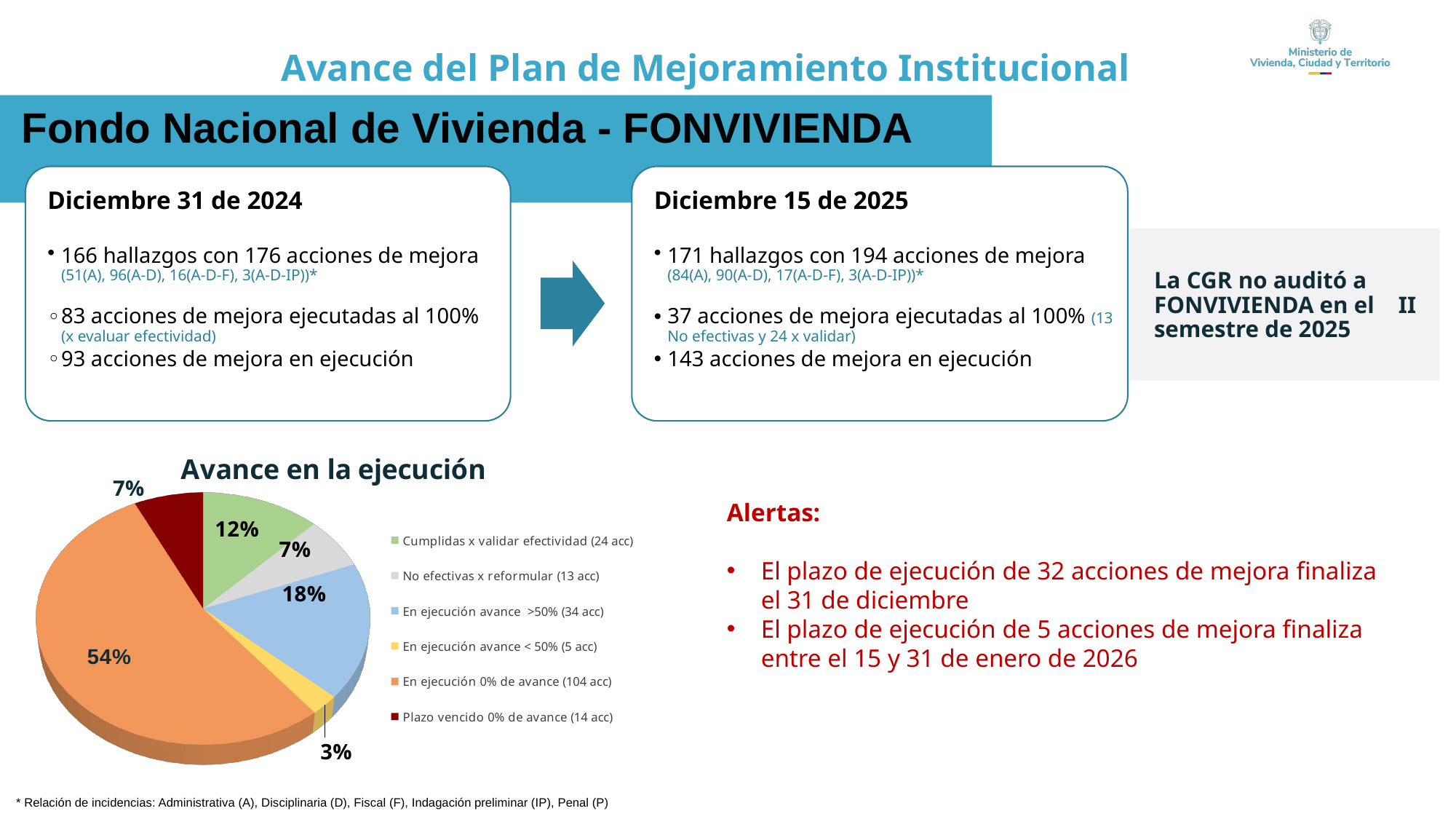
What percentage is shown for "En ejecución avance >50%" in the pie chart? 18% What is the title of the pie chart on the slide? Avance en la ejecución What percentage of the pie does "En ejecución 0% de avance" represent? 54% Which category has the smallest share in the "Avance en la ejecución" pie chart? En ejecución avance < 50% (5 acc) What is the difference in percentage points between "En ejecución 0% de avance" (54%) and "En ejecución avance >50%" (18%)? 36 percentage points What percentage is shown for "Cumplidas x validar efectividad" in the pie chart? 12% How many slices does the "Avance en la ejecución" pie chart have? 6 What percentage is shown for "Plazo vencido 0% de avance" in the pie chart? 7% Which is larger in the pie chart: "En ejecución avance >50%" or "Cumplidas x validar efectividad"? En ejecución avance >50% Which category has the largest share in the "Avance en la ejecución" pie chart? En ejecución 0% de avance (104 acc) How many entries does the legend of the pie chart list? 6 What kind of chart is shown under the title "Avance en la ejecución"? Pie chart